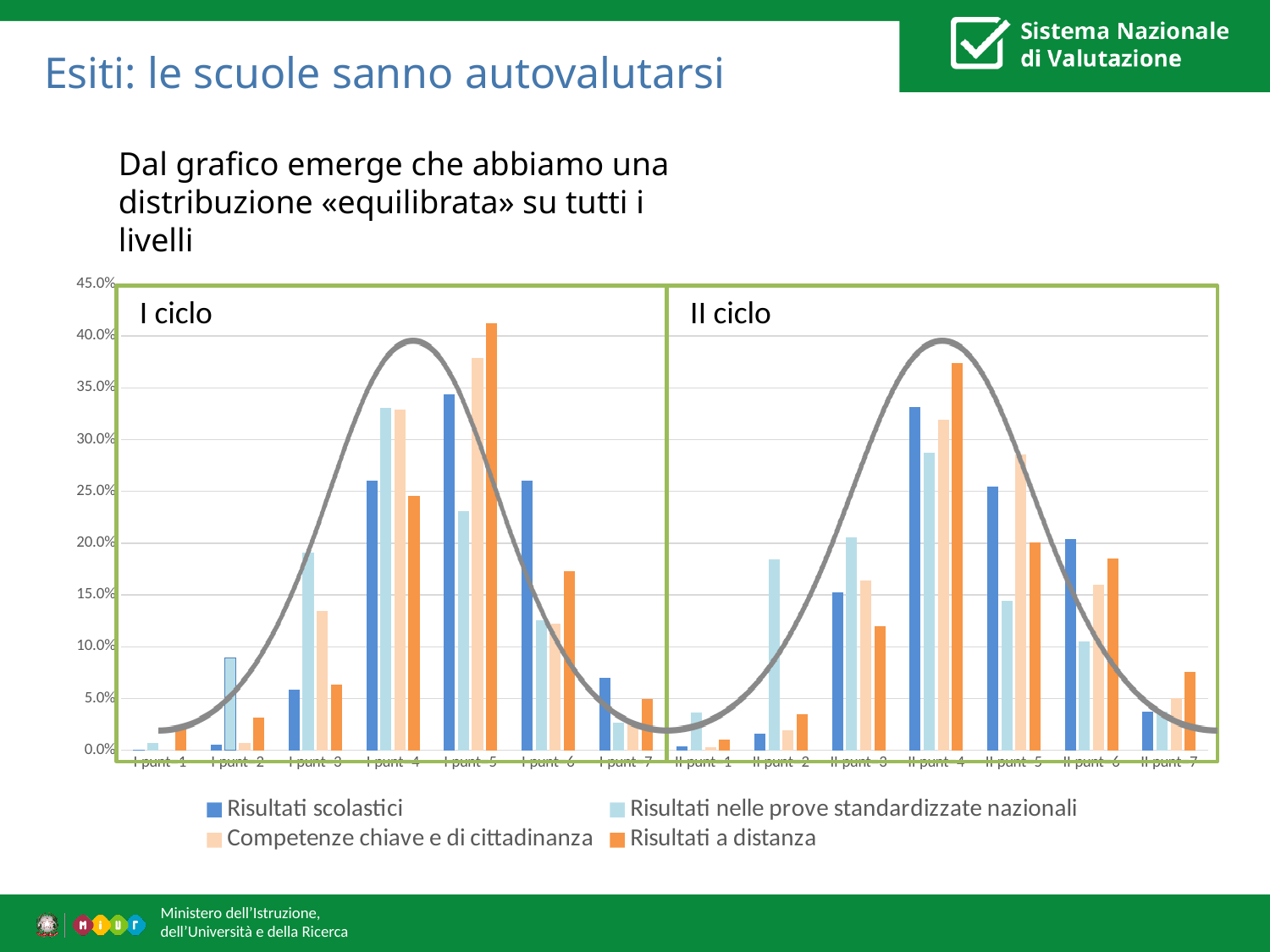
Do the values of Risultati scolastici rise or fall from I punt 5 to I punt 7? fall At I punt 5, which is larger: Risultati scolastici or Risultati a distanza? Risultati a distanza Is the value of Risultati nelle prove standardizzate nazionali for II punt 2 greater or less than 15%? greater Is the value of Risultati scolastici for I punt 7 greater or less than 10%? less How many categories are plotted along the x axis of the chart? 14 Which series is shown in orange in the legend? Risultati a distanza Which category has the highest value for Risultati a distanza? I punt 5 What are the two section labels written inside the chart area? I ciclo and II ciclo What kind of chart is shown on the slide? bar chart Is the value of Risultati scolastici for II punt 4 greater or less than 30%? greater How many series does the legend list? 4